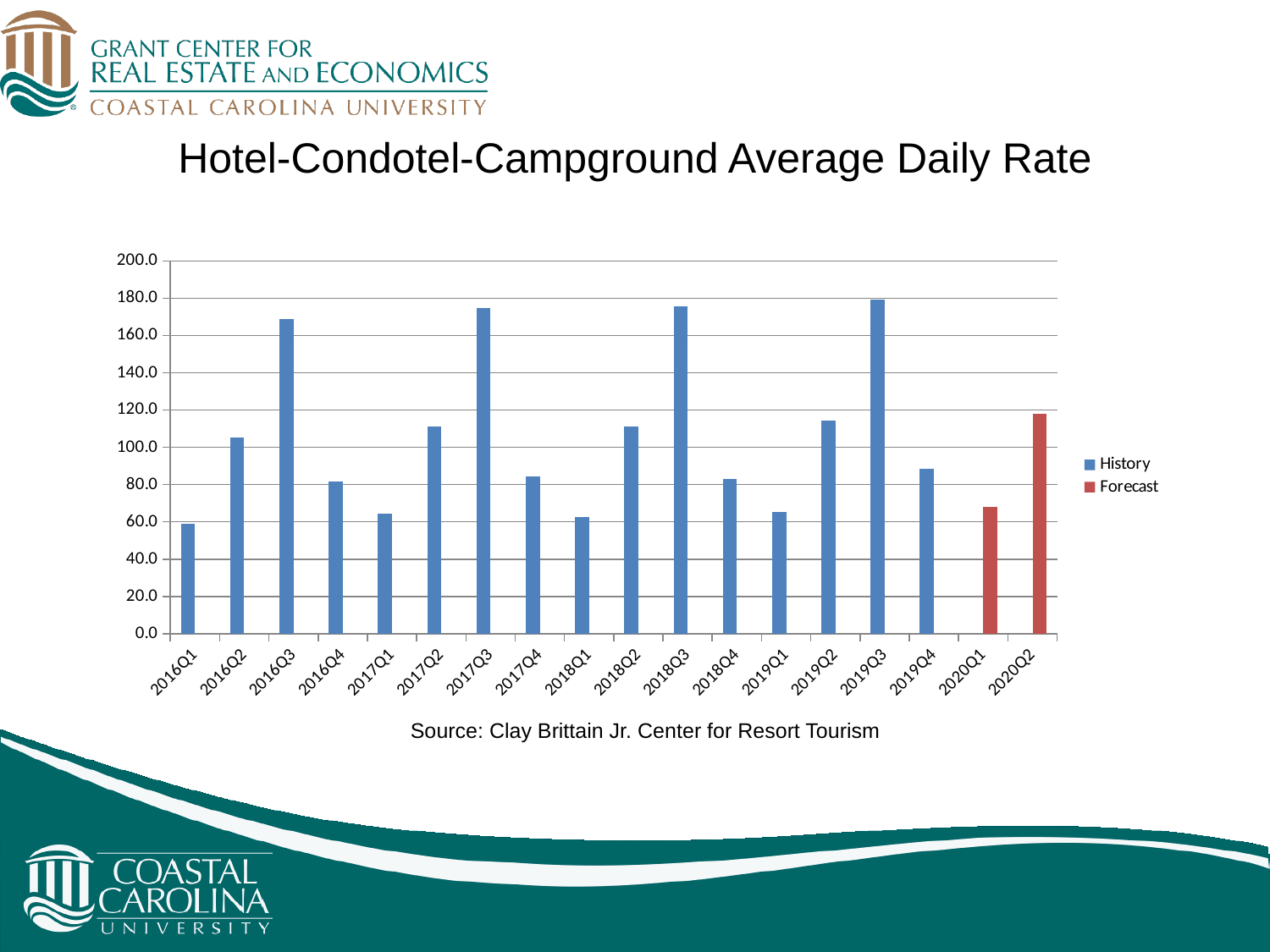
Which is larger, the value for 2020Q1 or the value for 2020Q2? 2020Q2 Which quarter has the highest average daily rate? 2019Q3 Which is larger, the value for 2017Q3 or the value for 2017Q4? 2017Q3 What are the two series named in the legend? History and Forecast Is the value for 2020Q2 greater or less than 100? greater How many series does the legend list? 2 Is the value for 2019Q3 greater or less than 160? greater Which quarters are shown as Forecast (red bars)? 2020Q1 and 2020Q2 How many quarters are plotted along the x axis? 18 Is the value for 2018Q4 greater or less than 100? less What kind of chart is shown on the slide? bar chart